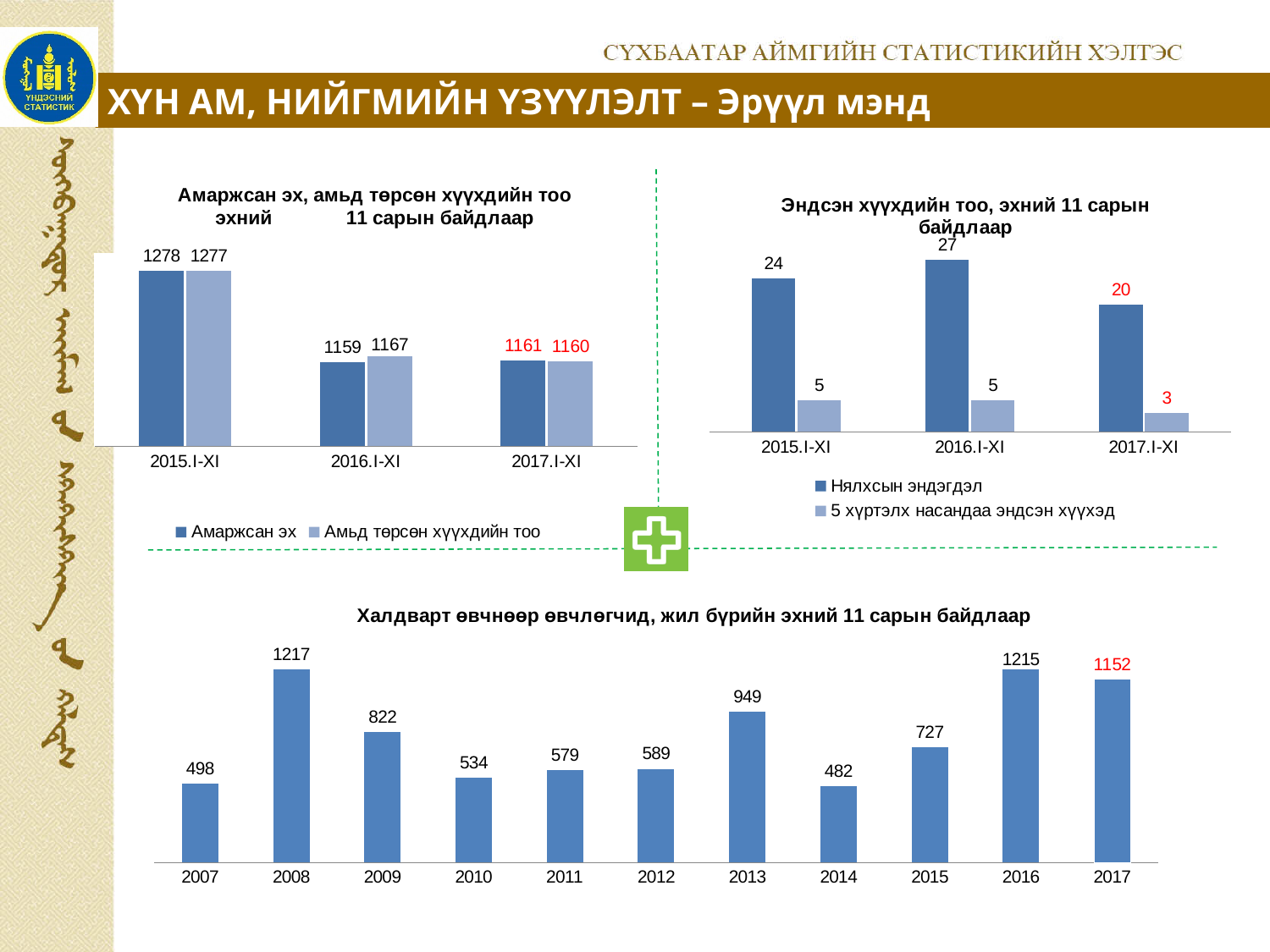
In the top-right chart (Эндсэн хүүхдийн тоо), which period has the highest value for Нялхсын эндэгдэл? 2016.I-XI In the bottom chart (Халдварт өвчнөөр өвчлөгчид), which year has the highest value? 2008 In the top-left chart (Амаржсан эх, амьд төрсөн хүүхдийн тоо), what is the value for Амьд төрсөн хүүхдийн тоо in 2016.I-XI? 1167 In the bottom chart (Халдварт өвчнөөр өвчлөгчид), what is the value for 2013? 949 In the top-left chart (Амаржсан эх, амьд төрсөн хүүхдийн тоо), how many series does the legend list? 2 In the top-left chart (Амаржсан эх, амьд төрсөн хүүхдийн тоо), what is the difference between Амаржсан эх in 2015.I-XI and in 2017.I-XI? 117 What kind of chart is the bottom chart (Халдварт өвчнөөр өвчлөгчид)? Bar chart In the bottom chart (Халдварт өвчнөөр өвчлөгчид), which year has the lowest value? 2014 In the bottom chart (Халдварт өвчнөөр өвчлөгчид), how many years are shown on the x axis? 11 In the top-right chart (Эндсэн хүүхдийн тоо), what is the value for Нялхсын эндэгдэл in 2016.I-XI? 27 In the top-right chart (Эндсэн хүүхдийн тоо), which period has the lowest value for 5 хүртэлх насандаа эндсэн хүүхэд? 2017.I-XI In the top-left chart (Амаржсан эх, амьд төрсөн хүүхдийн тоо), what is the value for Амаржсан эх in 2015.I-XI? 1278